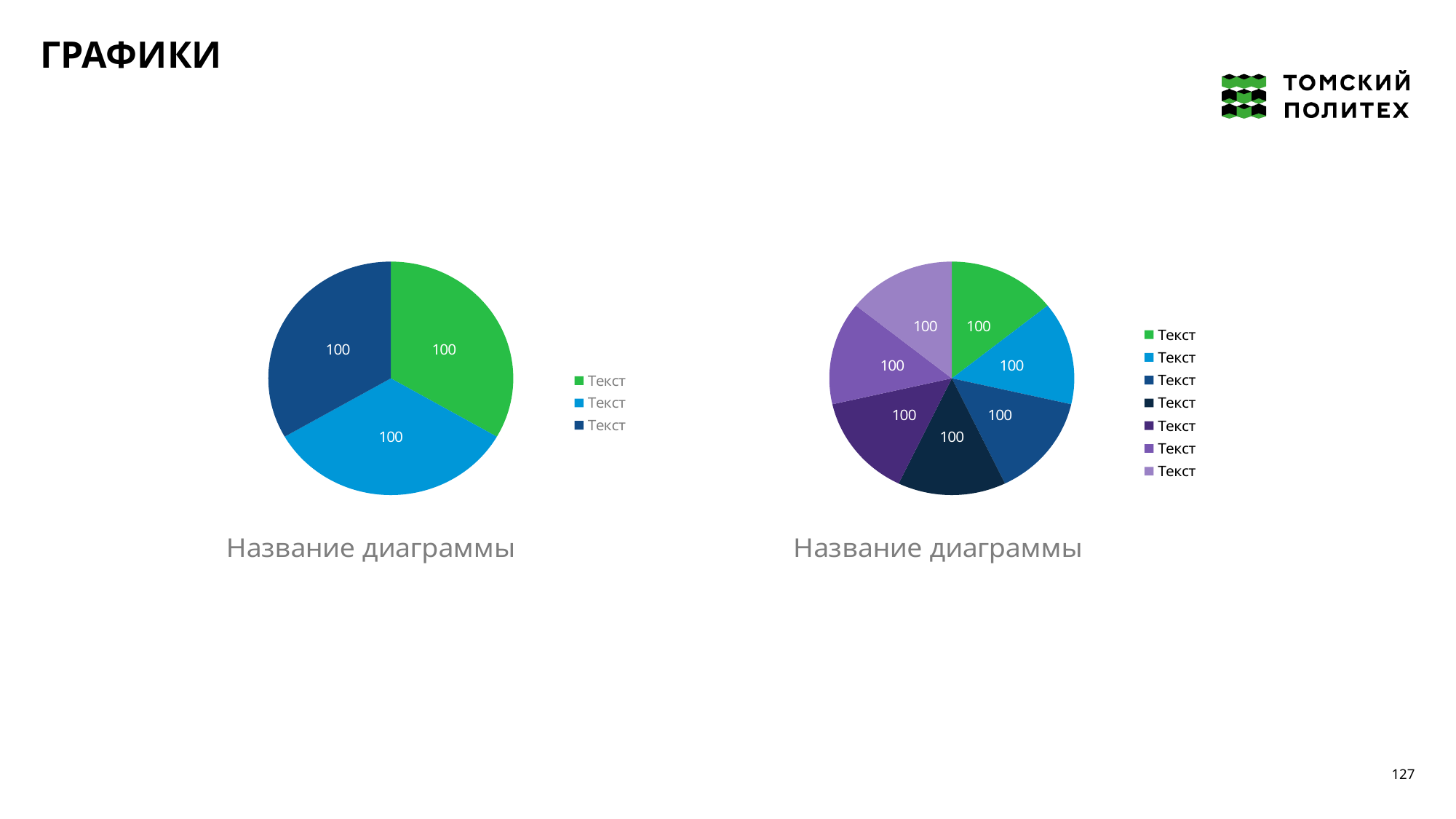
How many entries does the legend of the right pie chart list? 7 How many entries does the legend of the left pie chart list? 3 What is the total of all slice values in the left pie chart? 300 In the right pie chart, what value is printed on the light blue slice? 100 What kind of chart is the right chart on the slide? Pie chart What label is used for every legend entry in the right pie chart? Текст What is the title shown under the left pie chart? Название диаграммы How many slices does the left pie chart have? 3 How many slices does the right pie chart have? 7 What is the total of all slice values in the right pie chart? 700 What kind of chart is the left chart on the slide? Pie chart In the left pie chart, what value is printed on the green slice? 100